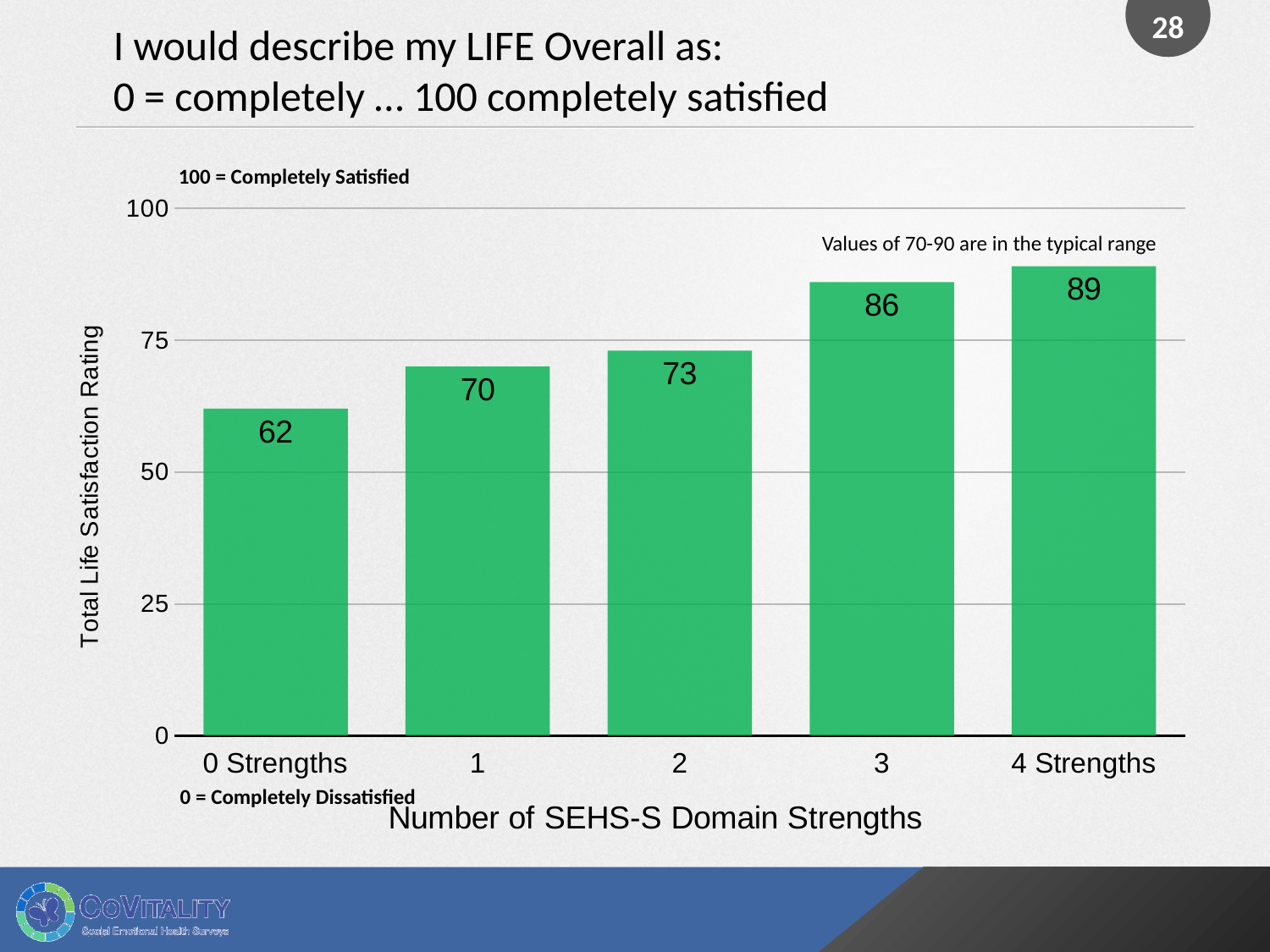
What is the difference in Total Life Satisfaction Rating between 3 strengths and 2 strengths? 13 How many categories of domain strengths are shown on the x axis? 5 What is the Total Life Satisfaction Rating for 0 Strengths? 62 Which number of SEHS-S domain strengths has the lowest Total Life Satisfaction Rating? 0 Strengths Is the Total Life Satisfaction Rating for 0 Strengths greater or less than 75? less What kind of chart is shown on the slide? bar chart Which number of SEHS-S domain strengths has the highest Total Life Satisfaction Rating? 4 Strengths What is the difference in Total Life Satisfaction Rating between 4 Strengths and 0 Strengths? 27 What is the Total Life Satisfaction Rating for 4 Strengths? 89 What is the Total Life Satisfaction Rating for 2 domain strengths? 73 Does the Total Life Satisfaction Rating rise or fall as the number of SEHS-S domain strengths increases? rise Which has a higher Total Life Satisfaction Rating, 1 strength or 3 strengths? 3 strengths